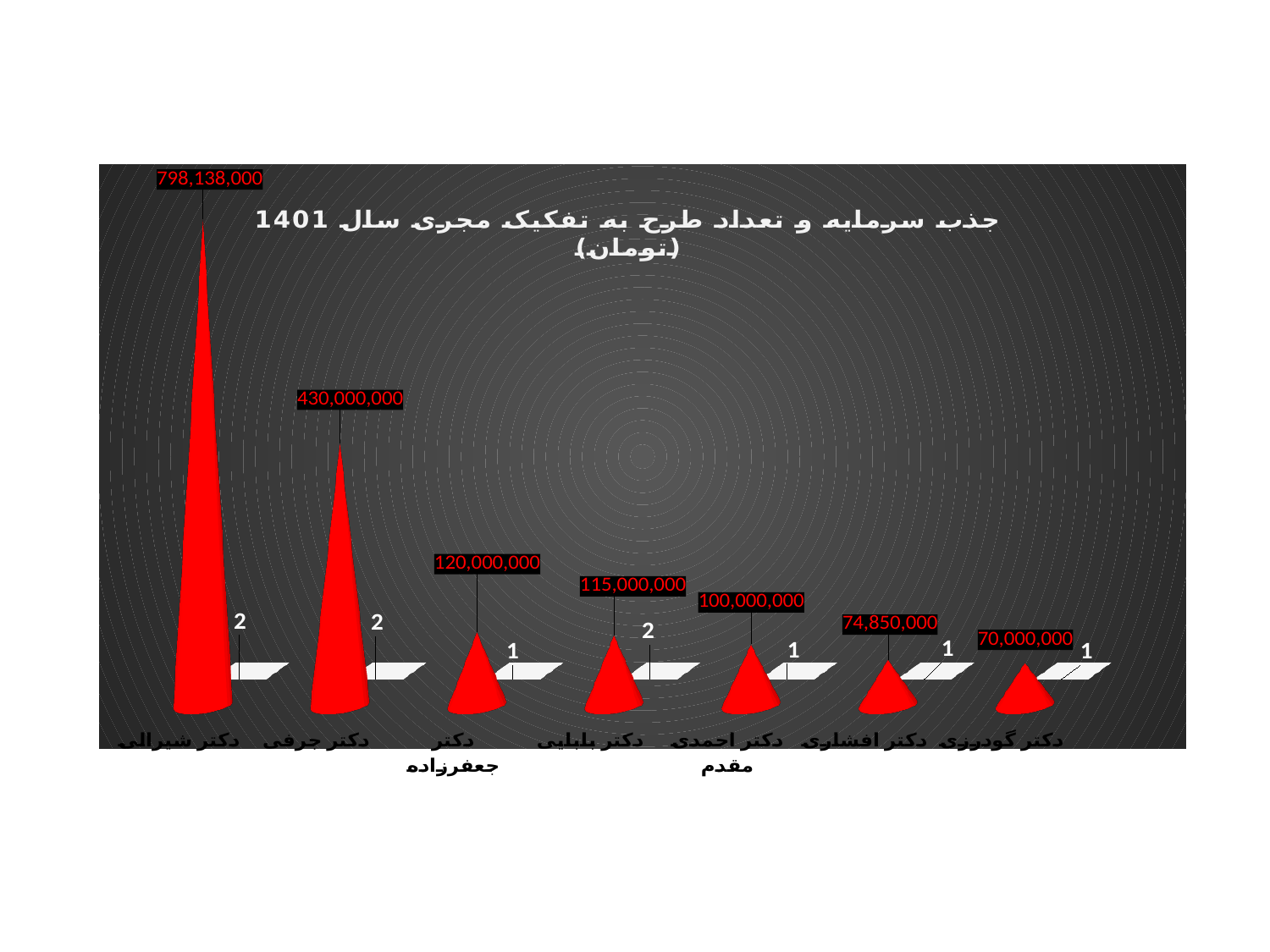
Which has a larger capital value, دکتر احمدی مقدم or دکتر افشاری? دکتر احمدی مقدم Which category has the lowest capital value? دکتر گودرزی How many categories (executors) are shown on the chart? 7 What is the capital value shown for دکتر افشاری? 74,850,000 What is the capital value shown for دکتر شیرالی? 798,138,000 How many projects are shown for دکتر بابایی? 2 What is the difference between the capital values of دکتر جعفرزاده and دکتر بابایی? 5,000,000 What is the title of the chart? جذب سرمایه و تعداد طرح به تفکیک مجری سال 1401 (تومان) Which category has the highest capital value? دکتر شیرالی How many projects are shown for دکتر گودرزی? 1 What is the difference between the capital values of دکتر شیرالی and دکتر جرفی? 368,138,000 What is the capital value shown for دکتر جرفی? 430,000,000